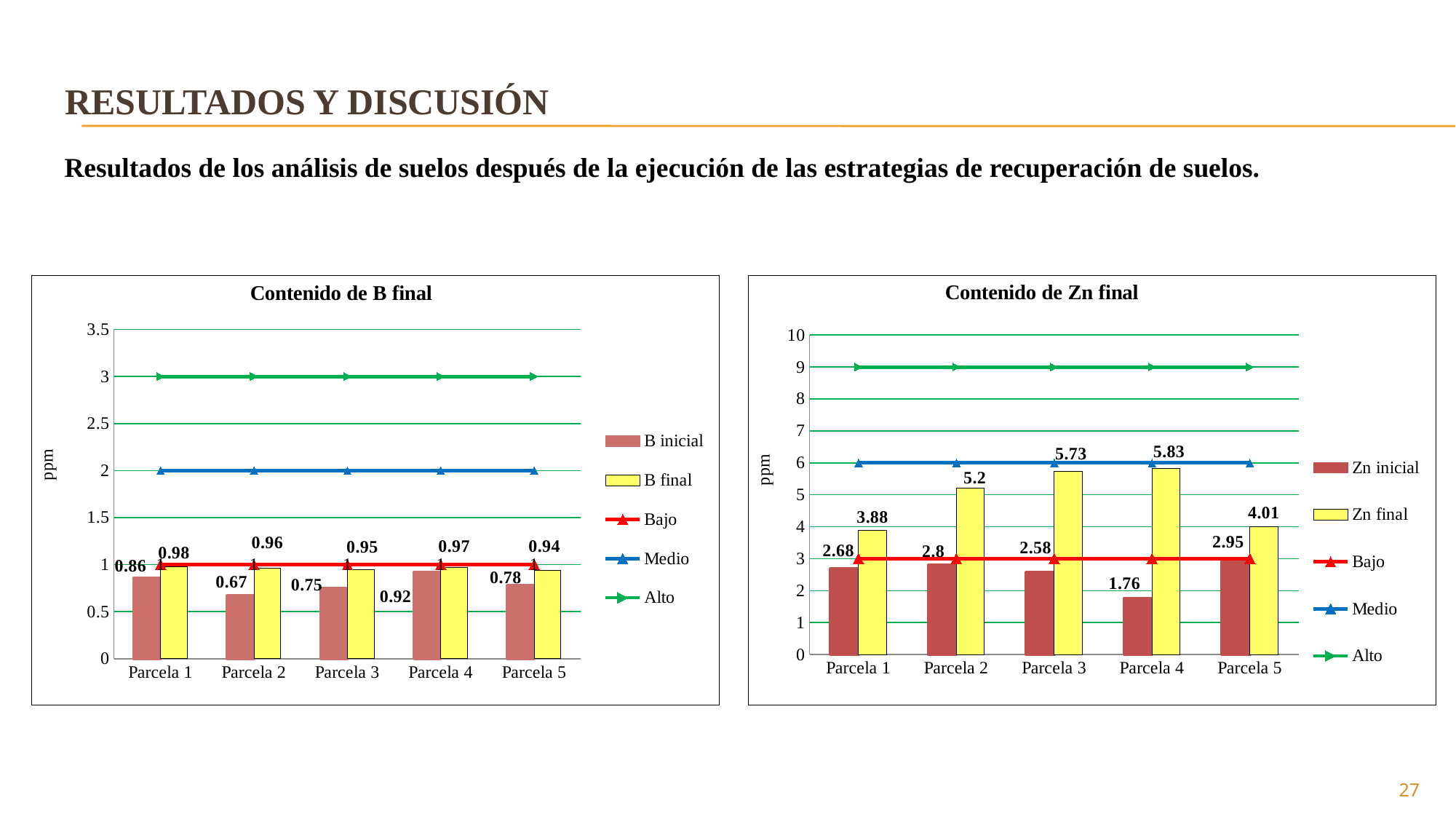
What kind of chart is 'Contenido de B final'? combination bar and line chart In the 'Contenido de Zn final' chart, what is the Zn final value for Parcela 3? 5.73 In the 'Contenido de Zn final' chart, is the Zn final value for Parcela 1 greater or less than 3? greater In the 'Contenido de Zn final' chart, what is the Zn inicial value for Parcela 4? 1.76 How many parcelas are shown on the x axis of the 'Contenido de B final' chart? 5 In the 'Contenido de Zn final' chart, what is the difference between Zn final and Zn inicial for Parcela 2? 2.4 In the 'Contenido de B final' chart, which is larger: the B inicial value for Parcela 1 or for Parcela 2? Parcela 1 What is the y-axis label of the 'Contenido de Zn final' chart? ppm In the 'Contenido de Zn final' chart, which parcela has the highest Zn final value? Parcela 4 How many series does the legend of the 'Contenido de Zn final' chart list? 5 In the 'Contenido de B final' chart, what is the B final value for Parcela 2? 0.96 In the 'Contenido de Zn final' chart, which parcela has the lowest Zn inicial value? Parcela 4